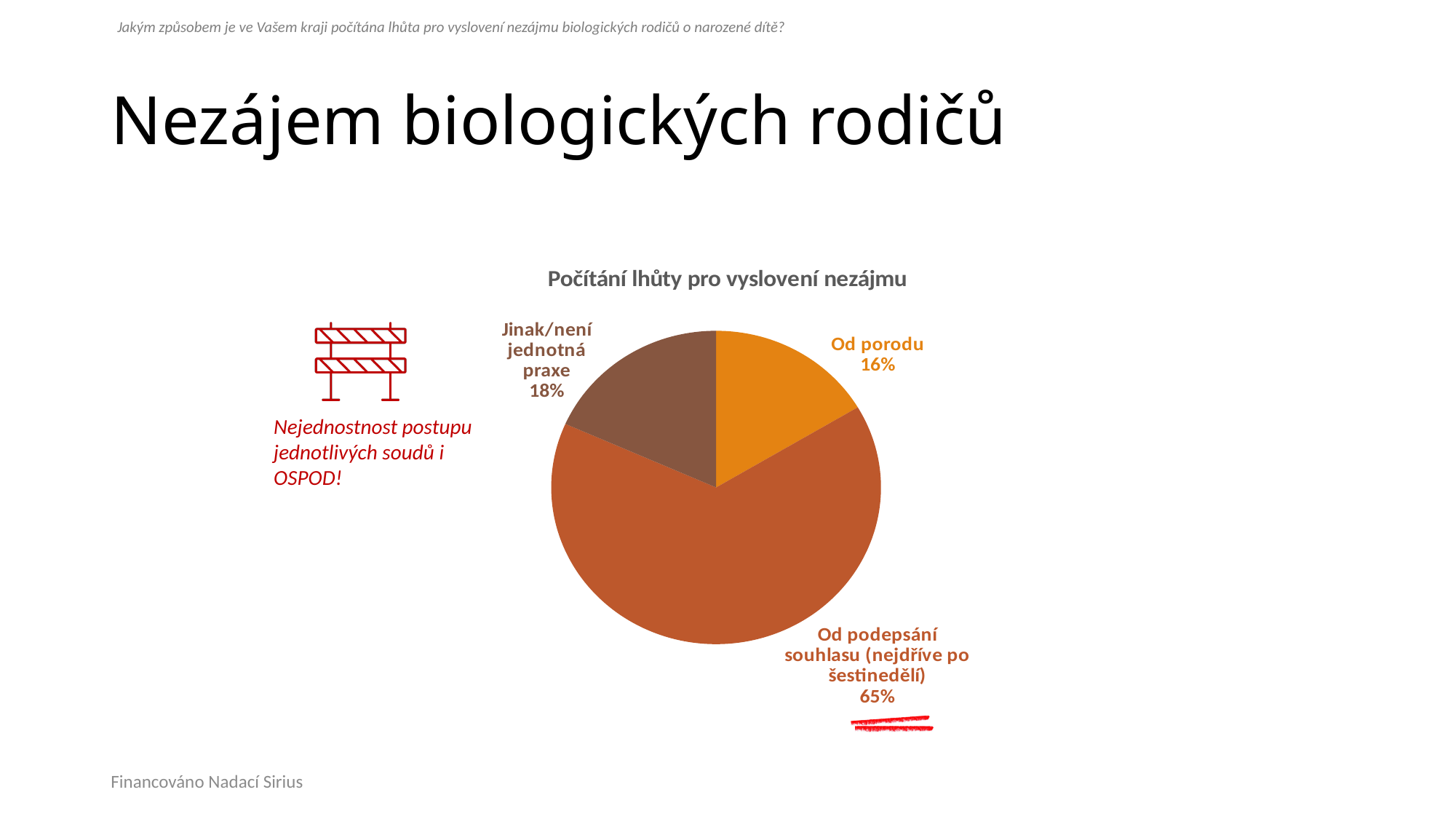
Which is larger, the slice for 'Od porodu' or the slice for 'Od podepsání souhlasu (nejdříve po šestinedělí)'? Od podepsání souhlasu (nejdříve po šestinedělí) What type of chart is shown on the slide? pie chart Which category has the largest slice of the pie? Od podepsání souhlasu (nejdříve po šestinedělí) What share of the pie does 'Od podepsání souhlasu (nejdříve po šestinedělí)' represent? 65% What is the difference in percentage points between 'Jinak/není jednotná praxe' and 'Od porodu'? 2 How many slices does the pie chart have? 3 What is the title of the chart? Počítání lhůty pro vyslovení nezájmu What is the difference in percentage points between 'Od podepsání souhlasu (nejdříve po šestinedělí)' and 'Jinak/není jednotná praxe'? 47 What colour is the slice for 'Od porodu'? orange What share of the pie does 'Od porodu' represent? 16% Which category has the smallest slice of the pie? Od porodu What share of the pie does 'Jinak/není jednotná praxe' represent? 18%